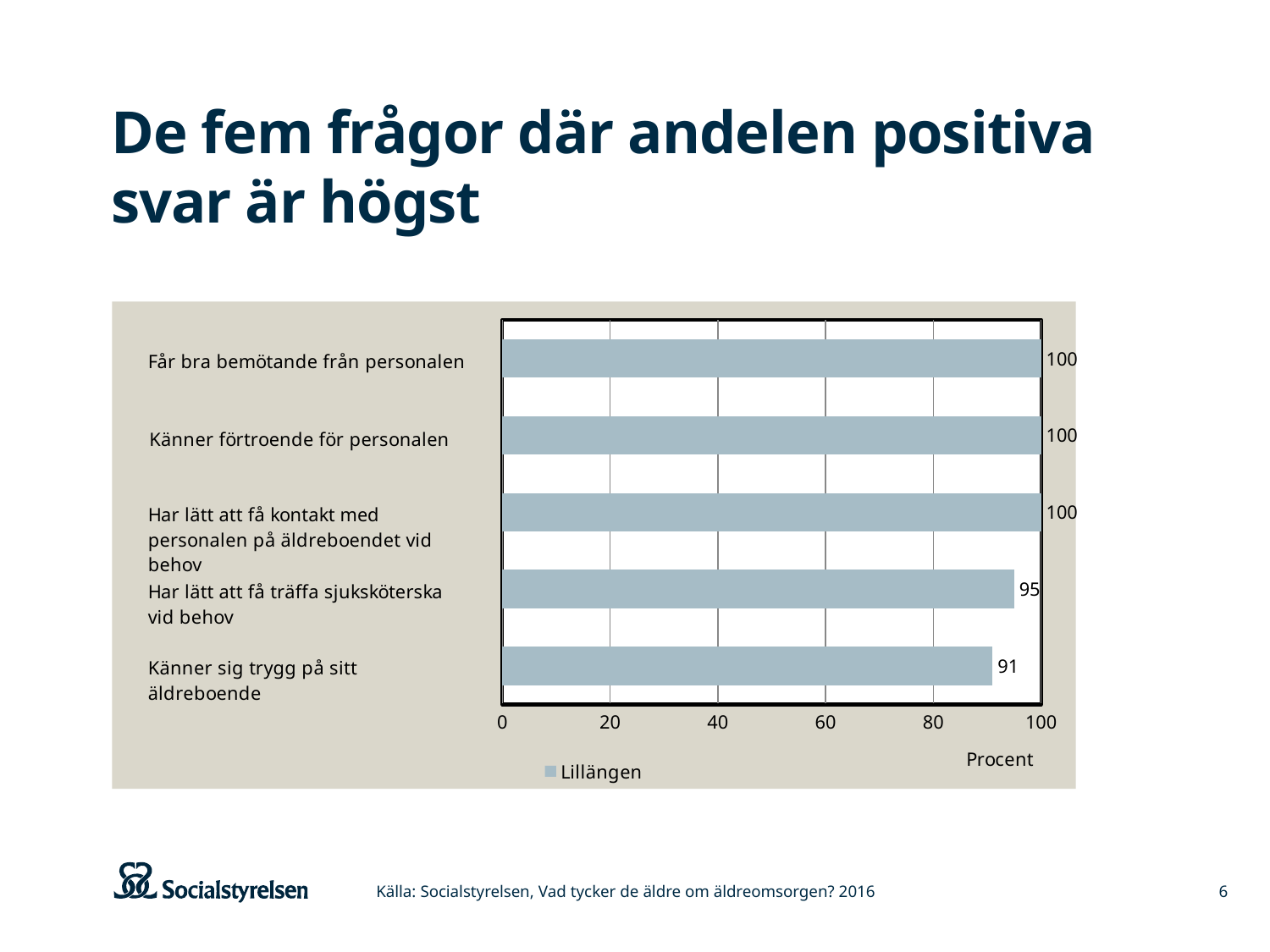
What is the value for "Har lätt att få träffa sjuksköterska vid behov"? 95 What is the name of the series shown in the legend? Lillängen How many series does the legend list? 1 Is the value for "Känner sig trygg på sitt äldreboende" greater or less than 80? greater What is the difference between the values for "Har lätt att få träffa sjuksköterska vid behov" and "Känner sig trygg på sitt äldreboende"? 4 What is the value for "Känner förtroende för personalen"? 100 How many categories are shown in the chart? 5 Which category has the lowest value? Känner sig trygg på sitt äldreboende What is the value for "Känner sig trygg på sitt äldreboende"? 91 What kind of chart is shown on the slide? bar chart What is the difference between the values for "Får bra bemötande från personalen" and "Känner sig trygg på sitt äldreboende"? 9 Which is larger, the value for "Har lätt att få träffa sjuksköterska vid behov" or the value for "Känner sig trygg på sitt äldreboende"? Har lätt att få träffa sjuksköterska vid behov